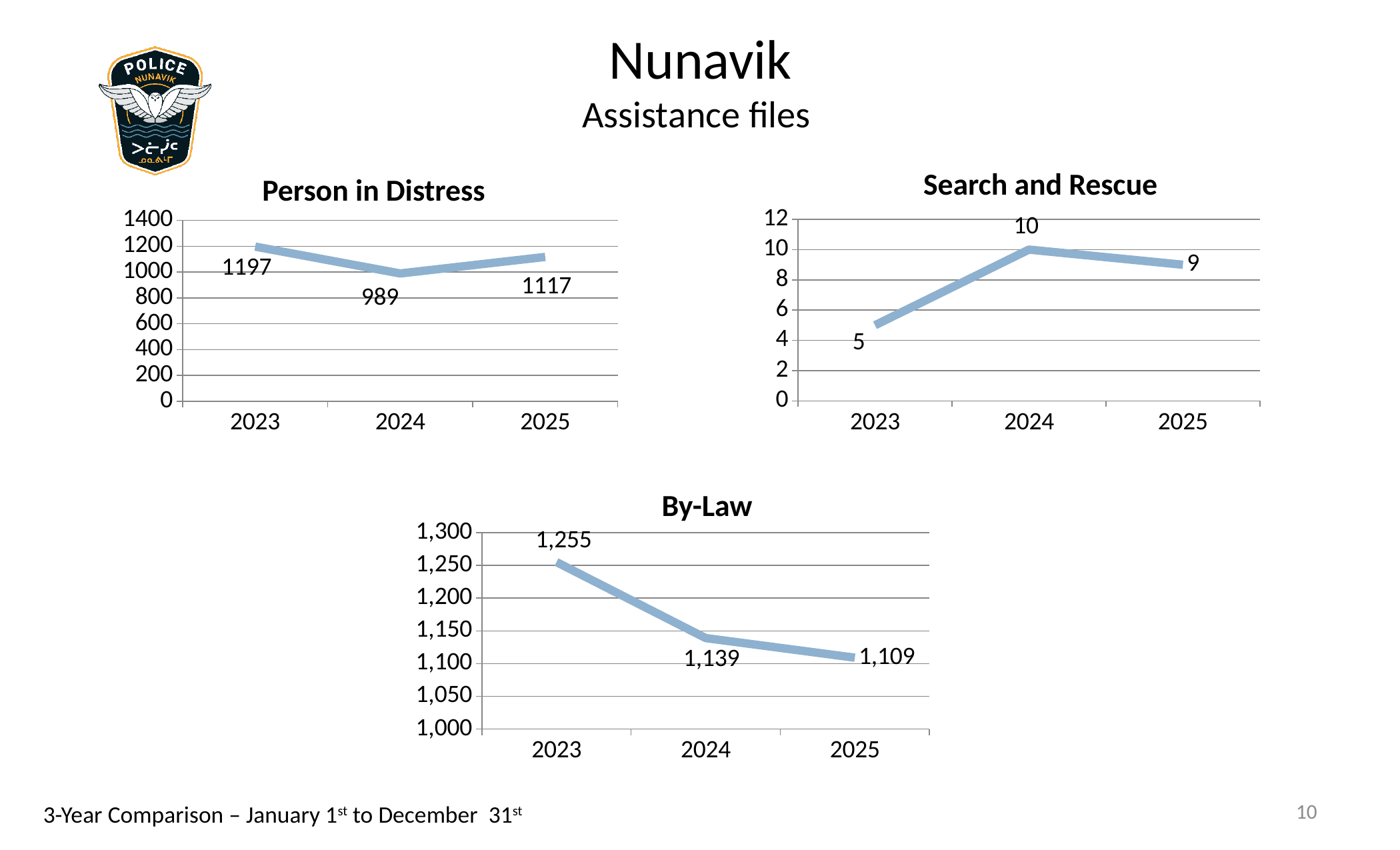
In the Search and Rescue chart, what is the difference between the 2024 and 2025 values? 1 In the By-Law chart, what is the value for 2023? 1,255 In the By-Law chart, which is larger, the value for 2024 or the value for 2025? 2024 In the By-Law chart, do the values rise or fall from 2023 to 2025? fall In the Person in Distress chart, what is the difference between the 2023 and 2025 values? 80 In the Person in Distress chart, what is the value for 2024? 989 In the Person in Distress chart, which year has the highest value? 2023 What kind of chart is the Search and Rescue chart? line chart In the Search and Rescue chart, which year has the lowest value? 2023 How many years are plotted in the Person in Distress chart? 3 In the Search and Rescue chart, what is the value for 2023? 5 In the By-Law chart, what is the difference between the 2024 and 2025 values? 30